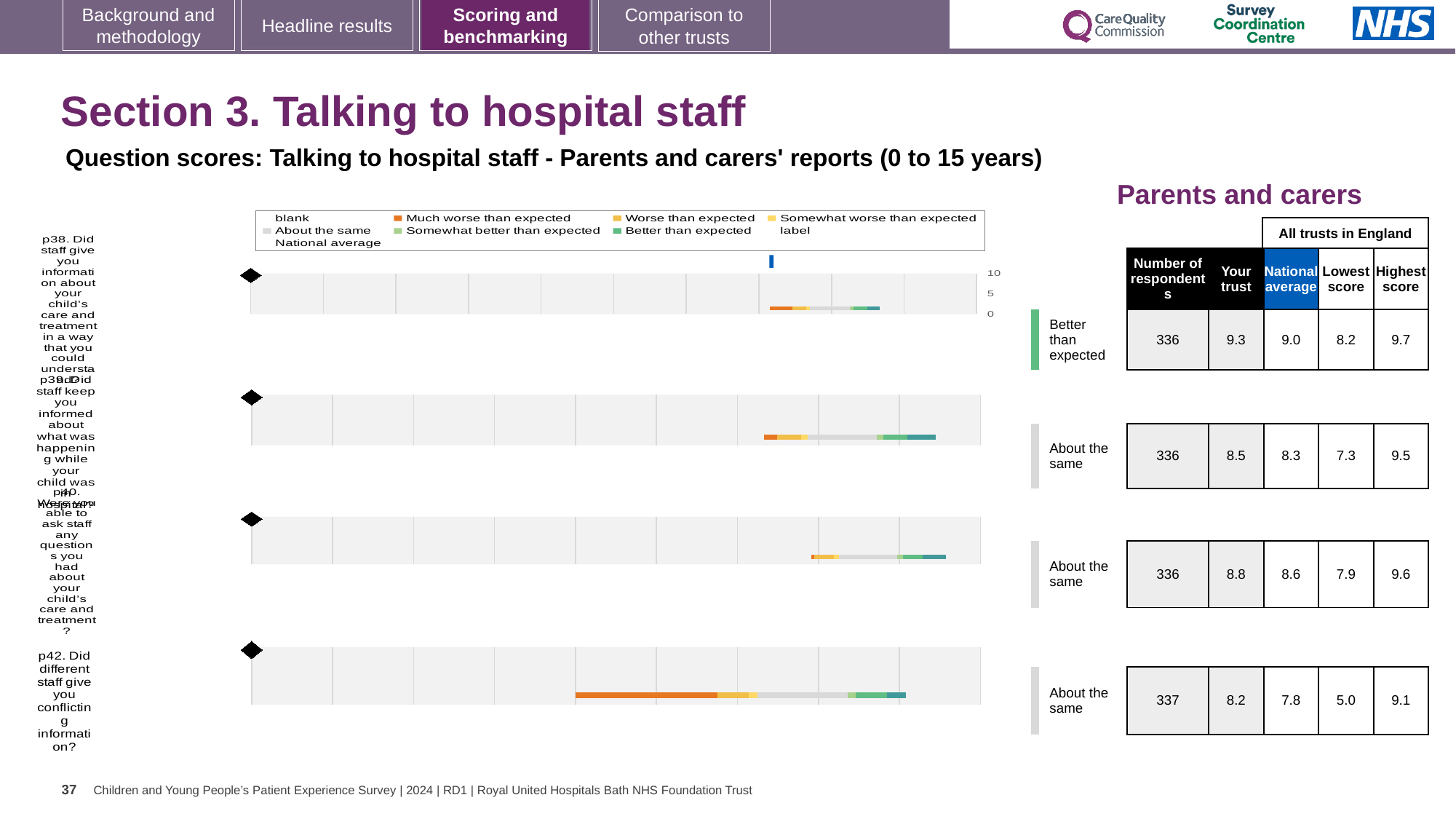
Which row of the table has the lowest 'Highest score' value? p42 (9.1) How many question charts are shown on the slide? 4 In the table, what is the number of respondents for the last row (p42)? 337 What kind of chart is used to show the question scores for p38? bar chart Which question is labelled 'Better than expected' next to its chart? p38 Which row of the table has the highest 'Your trust' score? p38 (9.3) In the table, what is the Lowest score for the last row (p42)? 5.0 In the table, what is the difference between 'Your trust' and the National average for the second row (p39)? 0.2 Which has the higher 'Your trust' score, the first row (p38) or the last row (p42)? p38 In the table, what is the 'Your trust' score for the first row (p38)? 9.3 What colour does the legend use for 'Much worse than expected'? orange In the table, what is the National average for the last row (p42)? 7.8